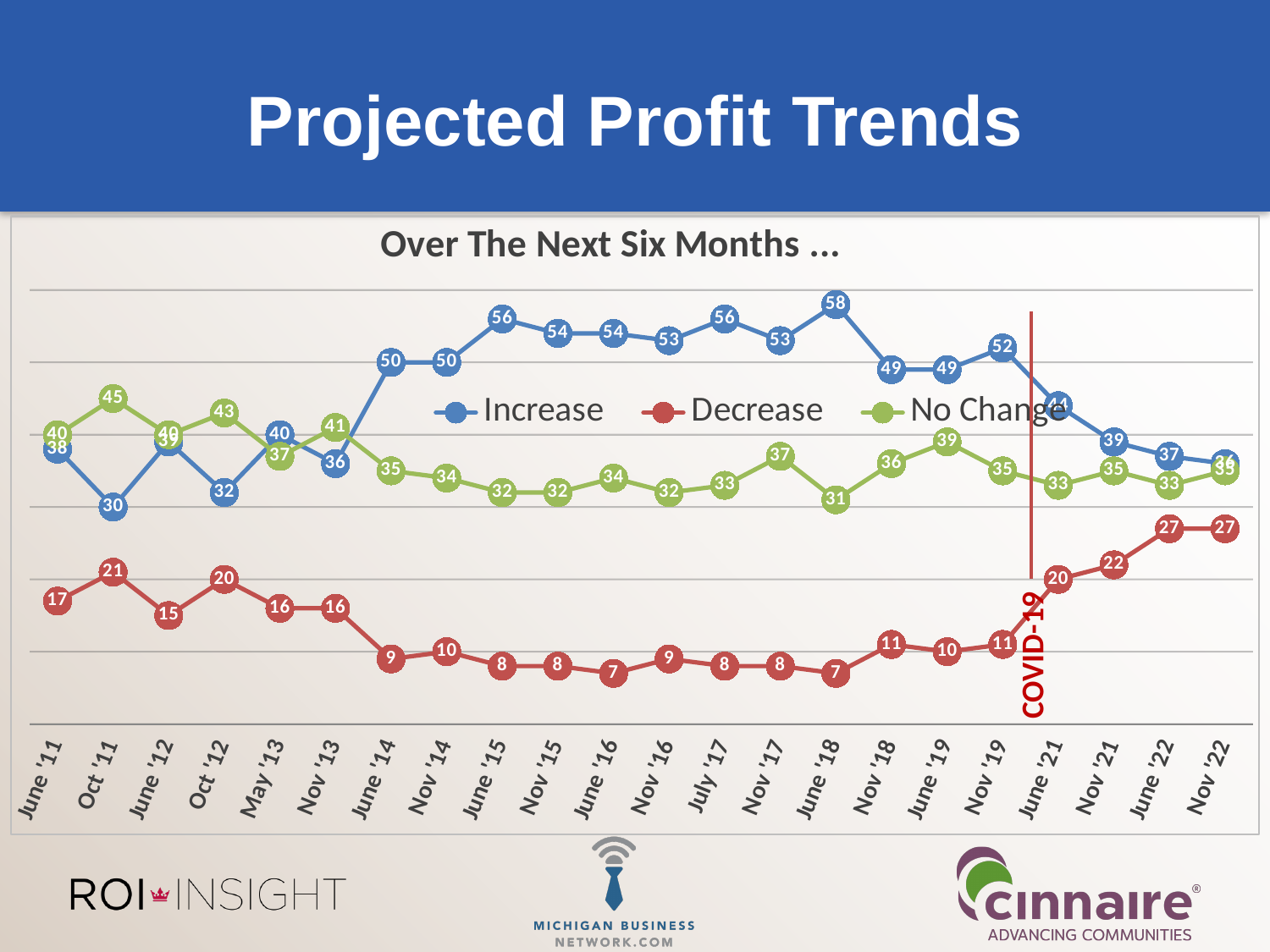
What label is written next to the vertical red line on the chart? COVID-19 What is the value of the Increase series at June '18? 58 At which time point does the Increase series reach its highest value? June '18 Which is larger for the Increase series: the value at Nov '19 or the value at June '21? Nov '19 Does the Decrease series rise or fall from Nov '19 to June '22? rise What kind of chart is shown on the slide? line chart What is the value of the No Change series at Oct '11? 45 How many series does the legend list? 3 What is the difference between the Increase values at June '18 and Nov '18? 9 How many time points are shown on the x axis? 22 What is the value of the Decrease series at Nov '21? 22 At which time point does the No Change series reach its lowest value? June '18